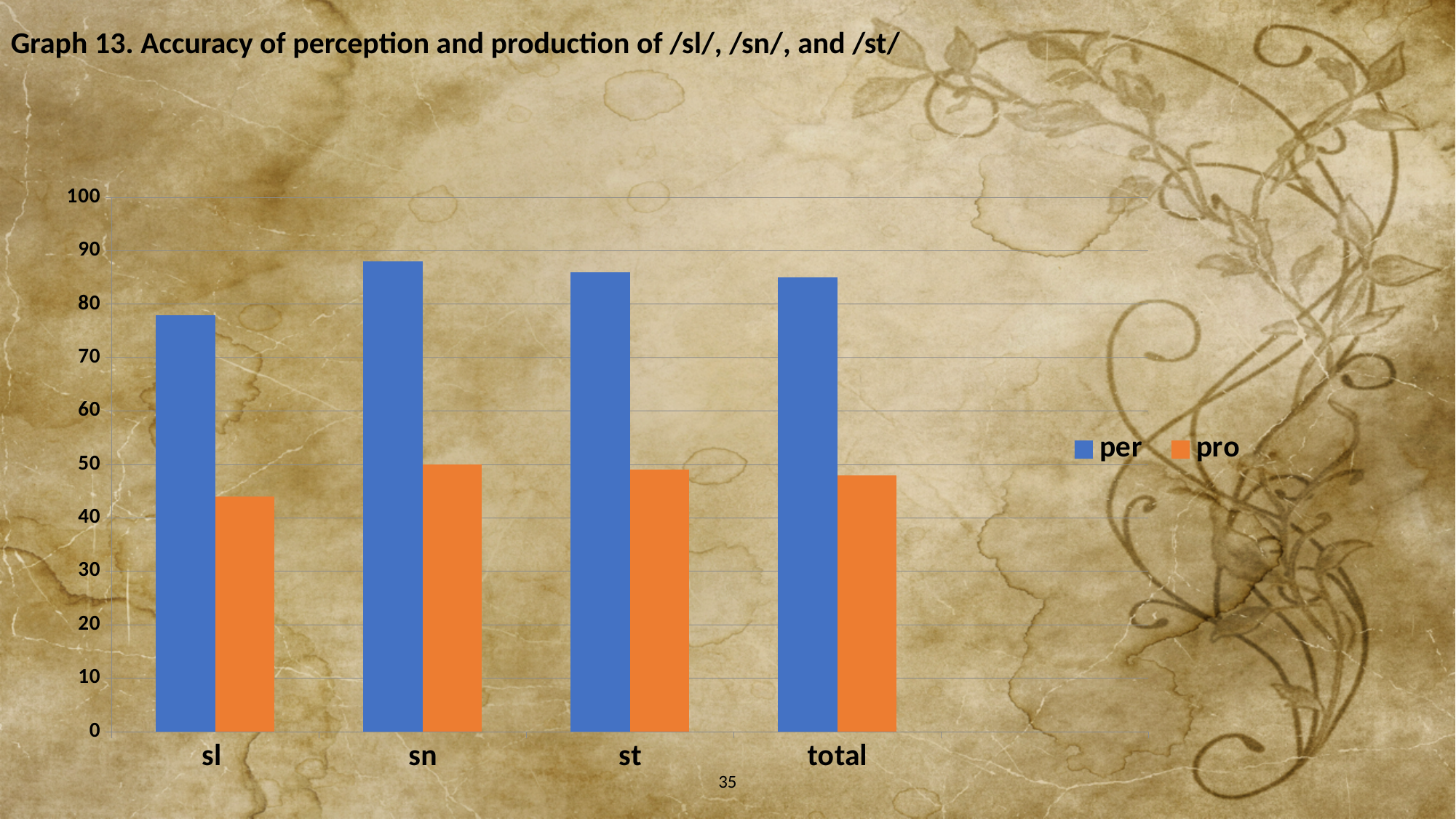
Is the pro value for sl greater or less than 50? less Is the per value for sn greater or less than 80? greater What are the two series names shown in the legend? per and pro How many series does the legend list? 2 Is the per value for sl greater or less than 70? greater Which category has the lowest value for the per series? sl Which category has the lowest value for the pro series? sl What kind of chart is shown on the slide? bar chart How many categories are shown on the x axis? 4 For the sl category, which is larger, per or pro? per For the total category, which is larger, per or pro? per